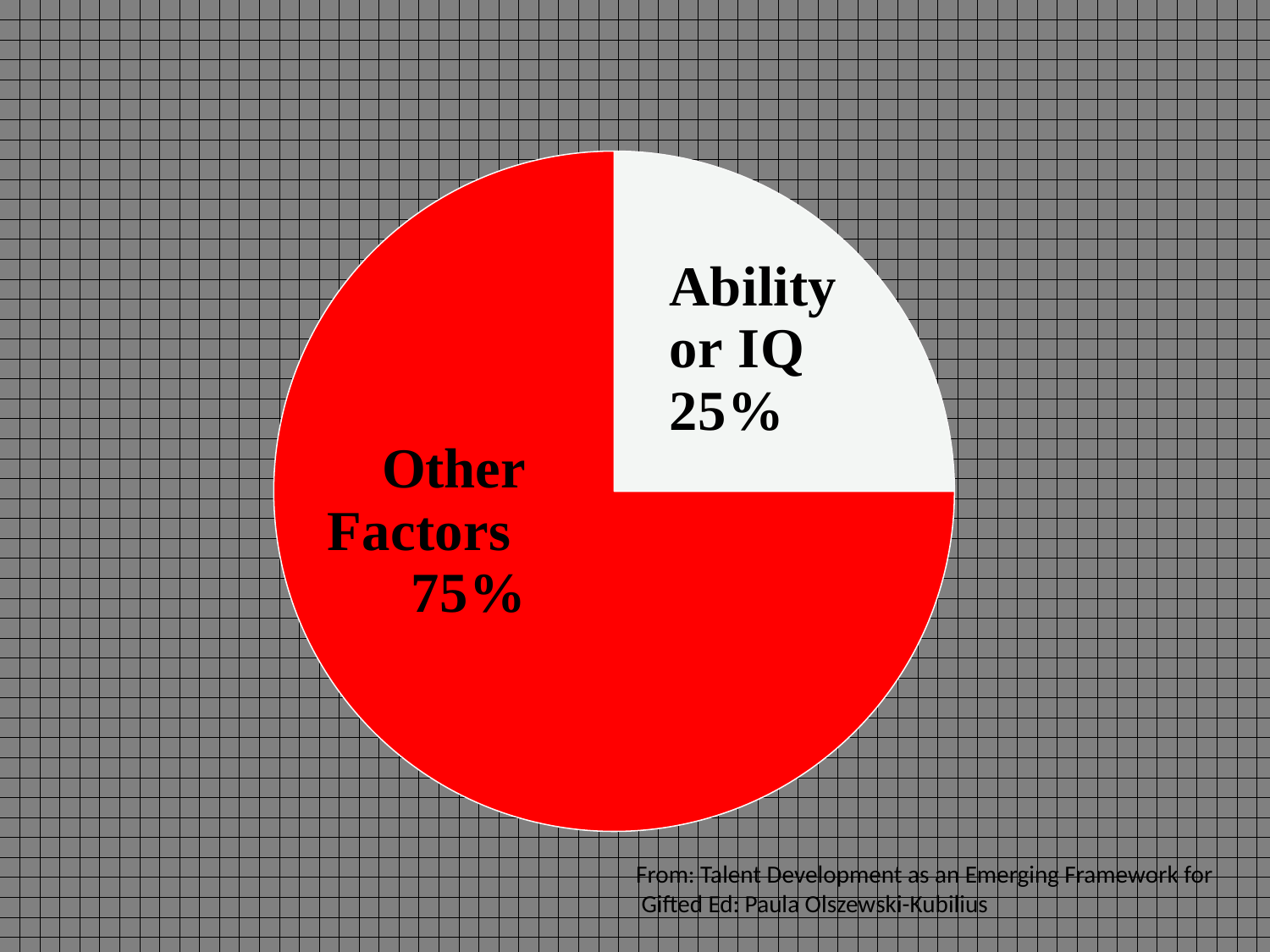
What colour is the Ability or IQ slice? white What share of the pie does Other Factors represent? 75% What share of the pie does Ability or IQ represent? 25% What kind of chart is shown on the slide? pie chart What colour is the Other Factors slice? red How many slices does the pie chart have? 2 Which slice of the pie is the smallest? Ability or IQ What is the difference in percentage points between Other Factors and Ability or IQ? 50 Which is larger, the Other Factors slice or the Ability or IQ slice? Other Factors Which slice of the pie is the largest? Other Factors